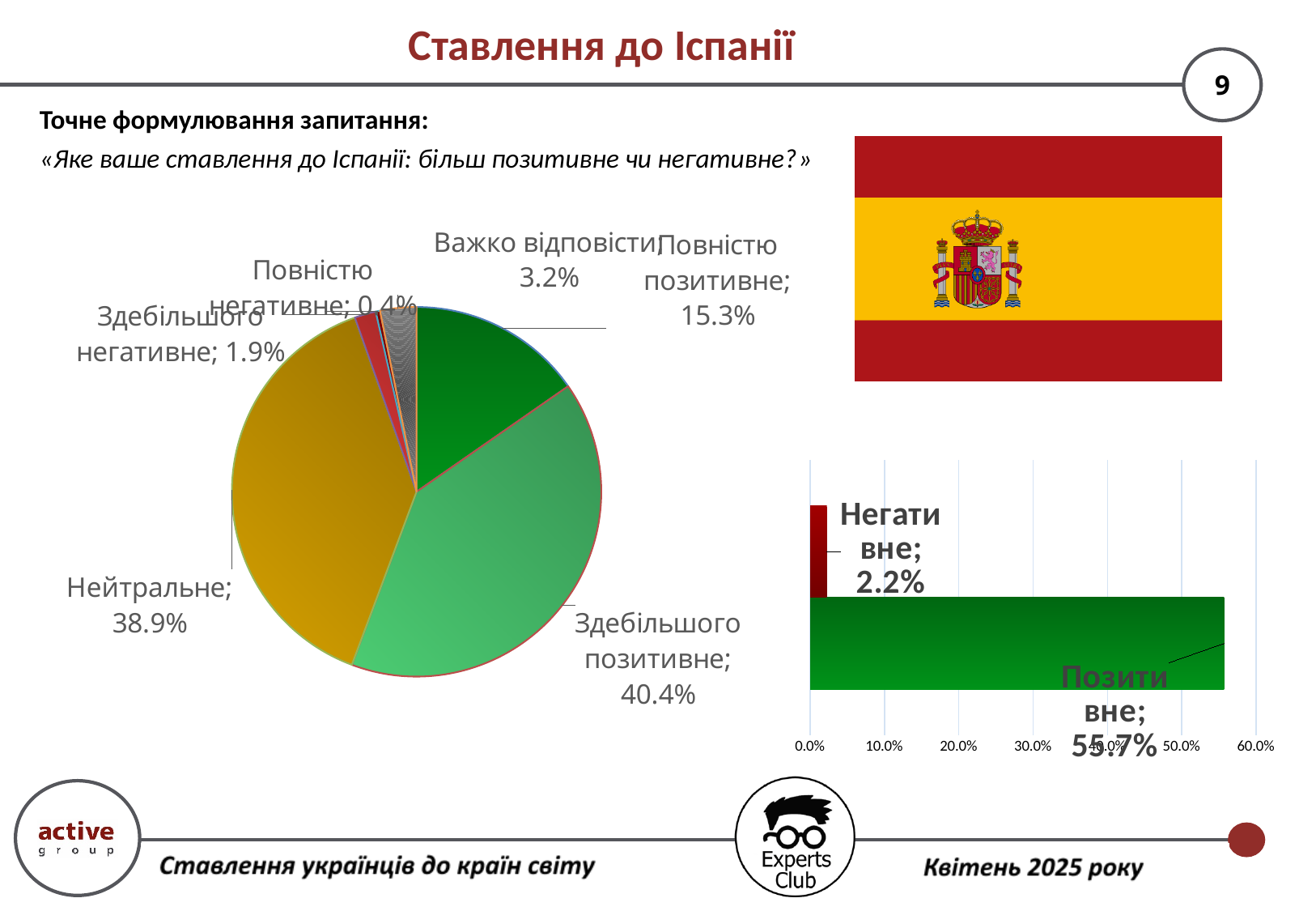
In the pie chart, which category has the smallest share? Повністю негативне In the pie chart, what share of respondents answered "Нейтральне"? 38.9% In the pie chart, how many categories are shown? 6 In the pie chart, which category has the largest share? Здебільшого позитивне In the bar chart on the right, what is the difference between "Позитивне" and "Негативне"? 53.5% In the pie chart, what share of respondents answered "Здебільшого позитивне"? 40.4% In the pie chart, what share of respondents answered "Повністю позитивне"? 15.3% In the pie chart, what share of respondents answered "Важко відповісти"? 3.2% What type of chart is shown on the right side of the slide? Bar chart In the bar chart on the right, what is the value for "Позитивне"? 55.7% In the pie chart, what is the difference between "Здебільшого негативне" and "Повністю негативне"? 1.5% In the bar chart on the right, what is the value for "Негативне"? 2.2%